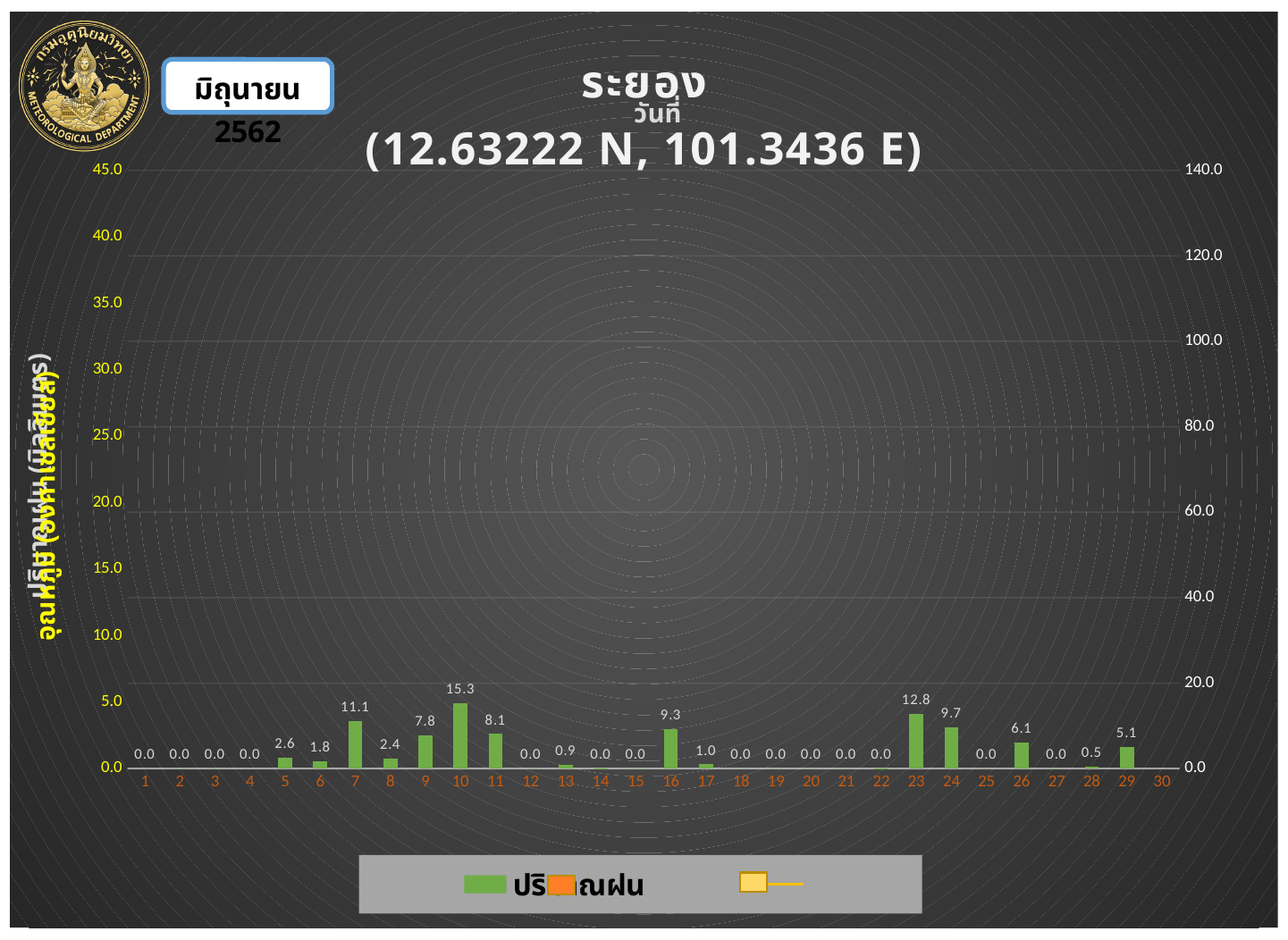
How many days are shown on the x axis? 30 What is the value shown for day 23? 12.8 What kind of chart is this? bar chart What is the highest tick value on the right-hand axis? 140.0 Which day has the highest bar? 10 What is the difference between the values for day 10 and day 23? 2.5 What is the value shown for day 10? 15.3 What is the value shown for day 7? 11.1 Is the value for day 16 greater or less than 5.0 on the left axis? greater What is the value shown for day 28? 0.5 Which is larger, the value for day 7 or the value for day 24? day 7 What is the difference between the values for day 24 and day 26? 3.6